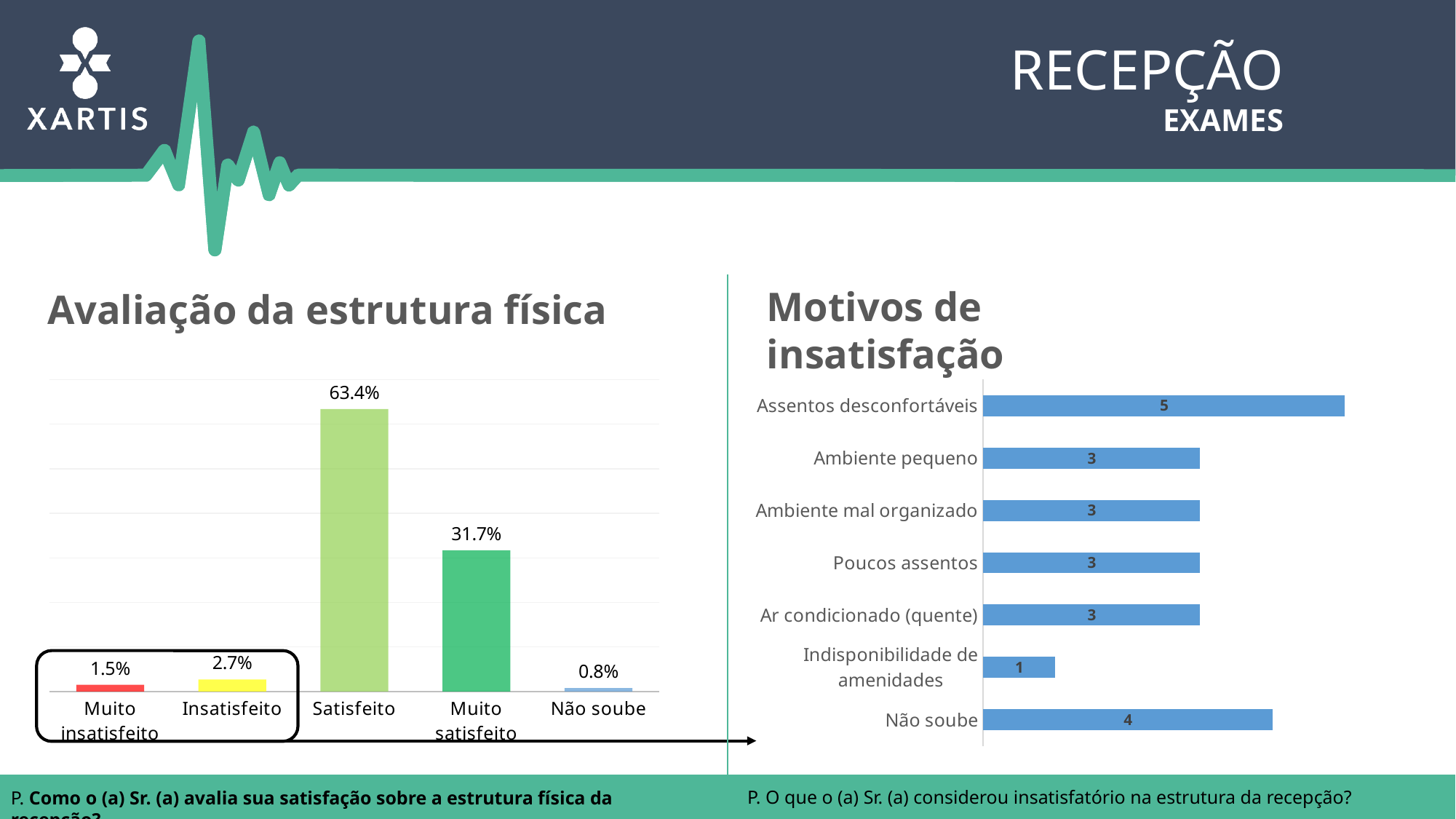
In the 'Motivos de insatisfação' chart, what is the value for Assentos desconfortáveis? 5 In the 'Motivos de insatisfação' chart, which category has the lowest value? Indisponibilidade de amenidades In the 'Avaliação da estrutura física' chart, which category has the lowest value? Não soube How many categories are shown in the 'Motivos de insatisfação' chart? 7 How many categories are shown in the 'Avaliação da estrutura física' chart? 5 In the 'Avaliação da estrutura física' chart, what is the value for Muito satisfeito? 31.7% In the 'Avaliação da estrutura física' chart, which is larger: Muito insatisfeito or Insatisfeito? Insatisfeito In the 'Motivos de insatisfação' chart, what is the difference between Assentos desconfortáveis and Não soube? 1 In the 'Avaliação da estrutura física' chart, which category has the highest value? Satisfeito In the 'Avaliação da estrutura física' chart, what is the value for Satisfeito? 63.4% In the 'Avaliação da estrutura física' chart, what is the difference between Satisfeito and Muito satisfeito? 31.7% What kind of chart is 'Motivos de insatisfação'? Bar chart